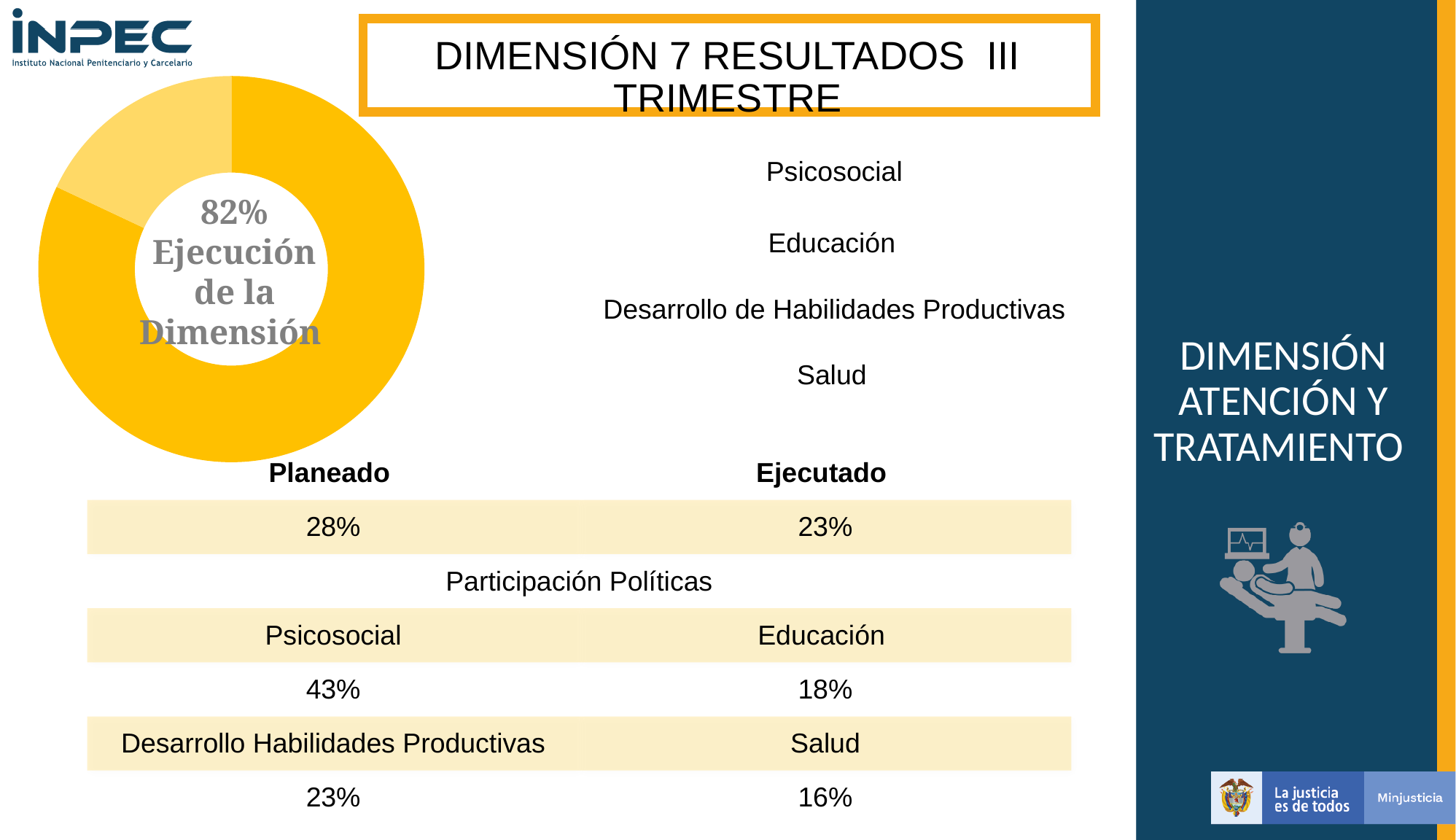
What share of the doughnut chart does the executed (Ejecución) portion represent? 82% What percentage is printed in the centre of the doughnut chart? 82% Does the doughnut chart display a legend? No What text accompanies the percentage in the centre of the doughnut chart? Ejecución de la Dimensión How many slices does the doughnut chart have? 2 Is the share of the light yellow slice in the doughnut chart greater or less than 25%? less Is the share of the dark yellow slice in the doughnut chart greater or less than 50%? greater What kind of chart is shown on the left of the slide? doughnut (pie) chart Which slice of the doughnut chart is larger, the dark yellow one or the light yellow one? the dark yellow one